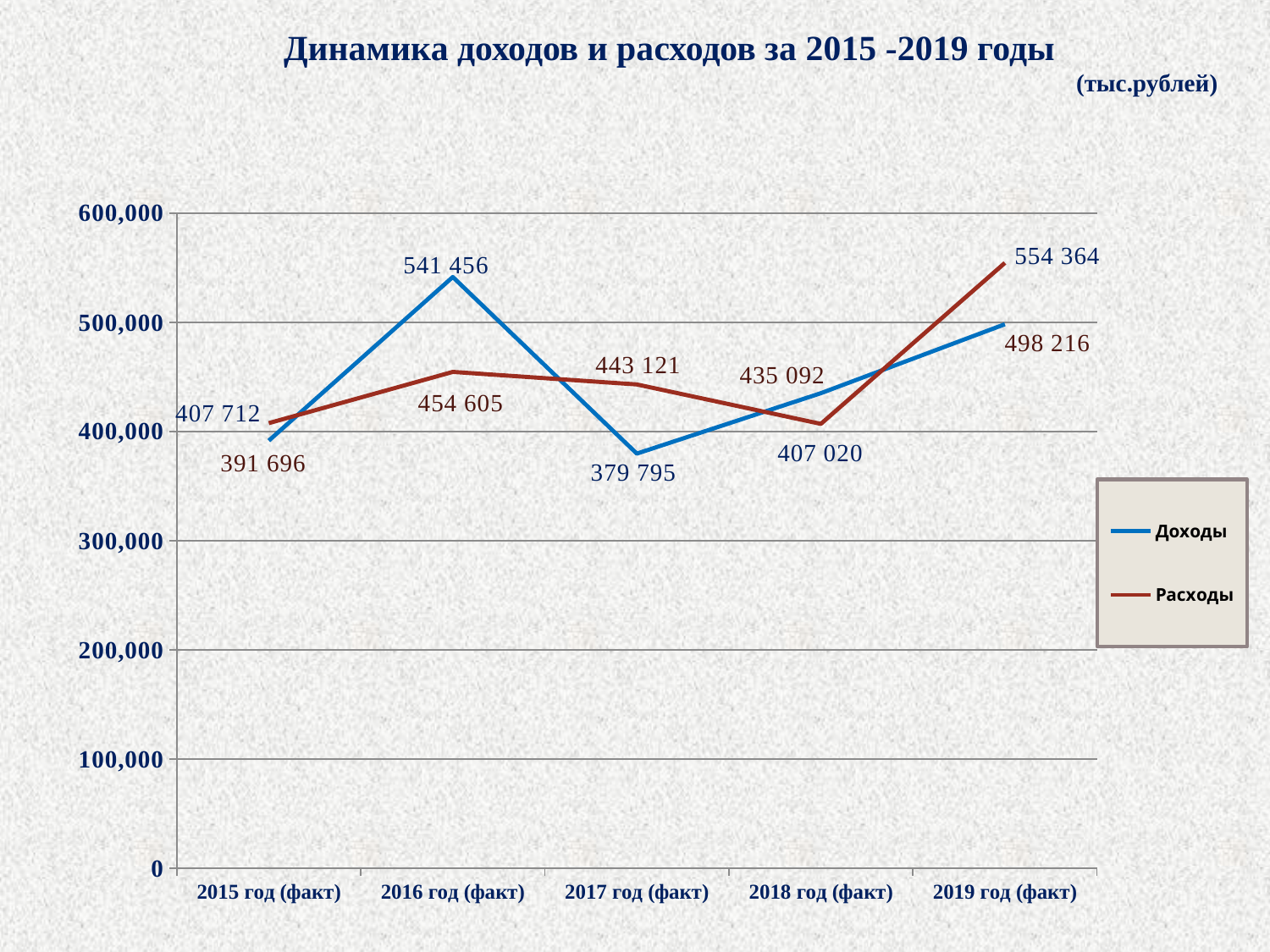
What is the value of Доходы for 2017 год (факт)? 379 795 What is the difference between Расходы and Доходы in 2019 год (факт)? 56 148 What is the value of Расходы for 2019 год (факт)? 554 364 In which year is Доходы the lowest? 2017 год (факт) What type of chart is shown on the slide? line chart What unit is stated under the chart title? тыс.рублей In which year is Доходы the highest? 2016 год (факт) How many series does the legend list? 2 Which is larger in 2018 год (факт), Доходы or Расходы? Доходы How many years are plotted along the x axis? 5 In which year is Расходы the highest? 2019 год (факт) What is the value of Доходы for 2016 год (факт)? 541 456